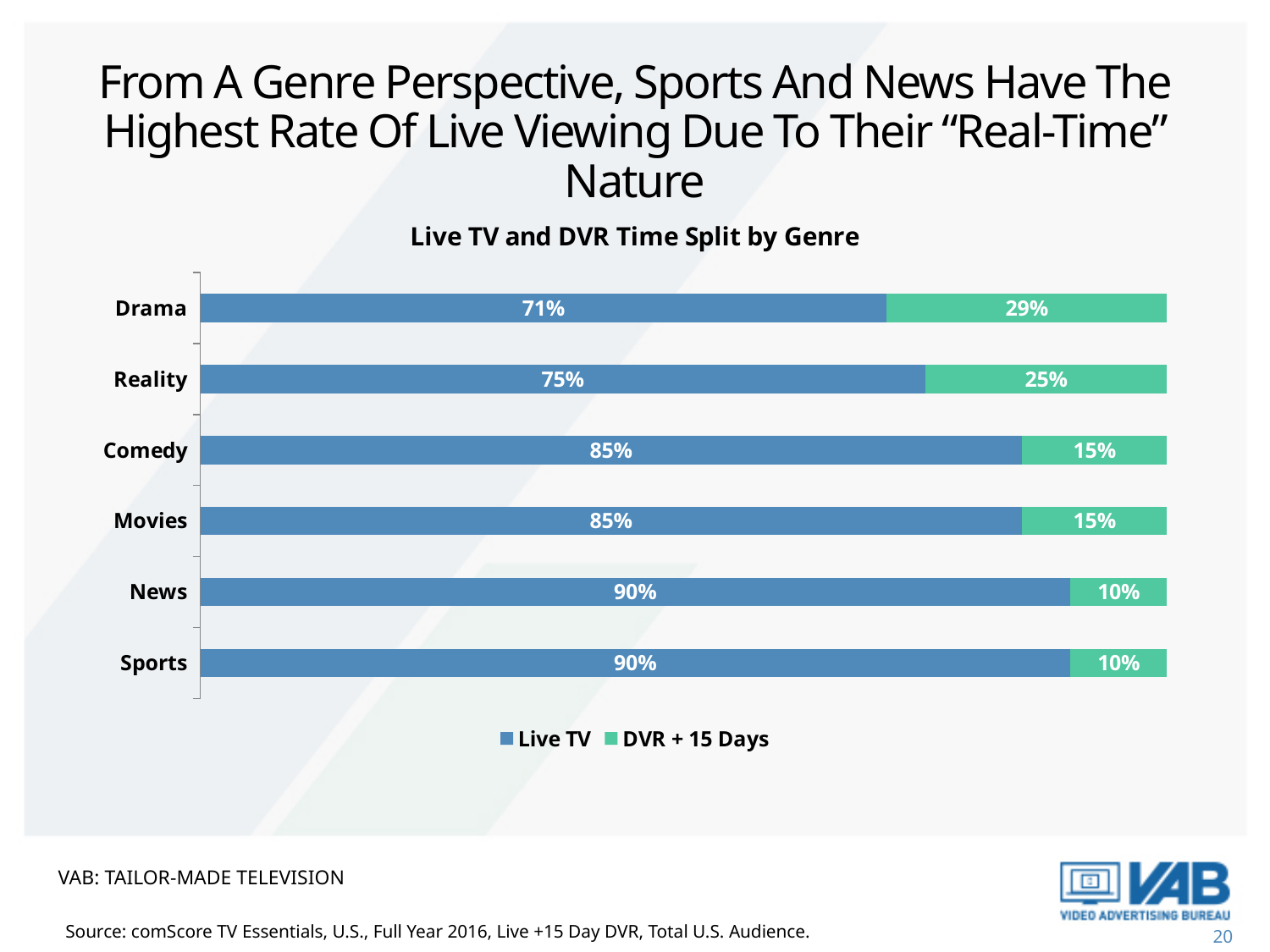
What is the DVR + 15 Days value for News? 10% How many genres are shown in the chart? 6 What is the Live TV value for Comedy? 85% What is the DVR + 15 Days value for Reality? 25% What is the difference between the Live TV values for Reality and Drama? 4% Which genre has the lowest Live TV share? Drama What is the title of the chart? Live TV and DVR Time Split by Genre How many series does the legend list? 2 Which is larger, the DVR + 15 Days value for Reality or for Comedy? Reality What is the Live TV value for Drama? 71% Which genre has the highest DVR + 15 Days share? Drama What kind of chart is shown on the slide? Stacked bar chart